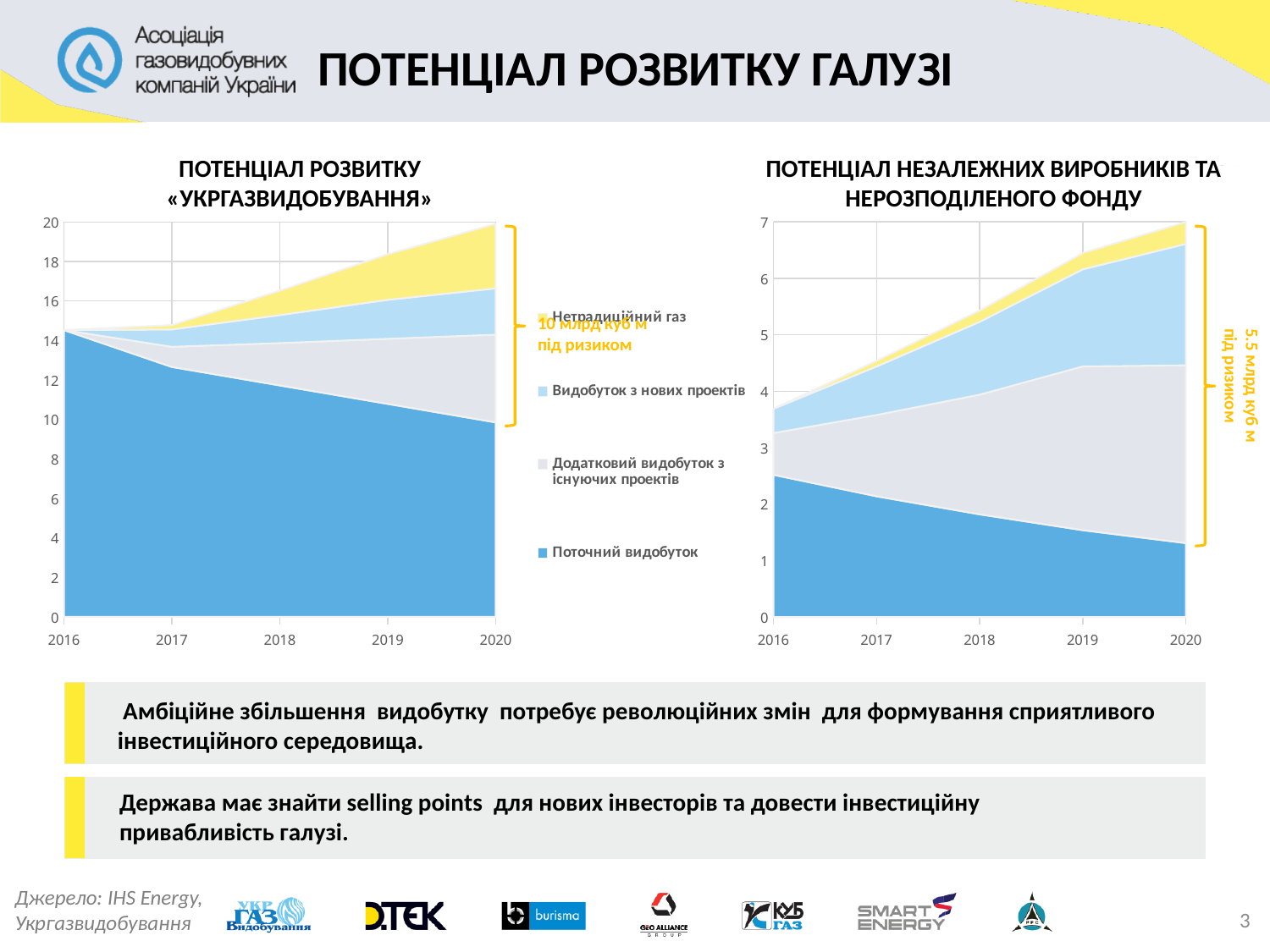
In the left chart, is the total stacked value in 2020 greater or less than 18? greater In the left chart, does the «Поточний видобуток» series rise or fall from 2016 to 2020? Falls In the right chart, is the total stacked value in 2016 greater or less than 4? less In the right chart, is the total stacked value in 2020 greater or less than 6? greater How many years are shown on the x axis of the right chart «ПОТЕНЦІАЛ НЕЗАЛЕЖНИХ ВИРОБНИКІВ ТА НЕРОЗПОДІЛЕНОГО ФОНДУ»? 5 In the left chart, does the total stacked value rise or fall from 2016 to 2020? Rises What amount is labelled as «під ризиком» next to the right chart? 5.5 млрд куб м What kind of chart is the left chart titled «ПОТЕНЦІАЛ РОЗВИТКУ «УКРГАЗВИДОБУВАННЯ»»? Stacked area chart How many series does the legend of the left chart list? 4 In which year does the right chart reach its highest total stacked value? 2020